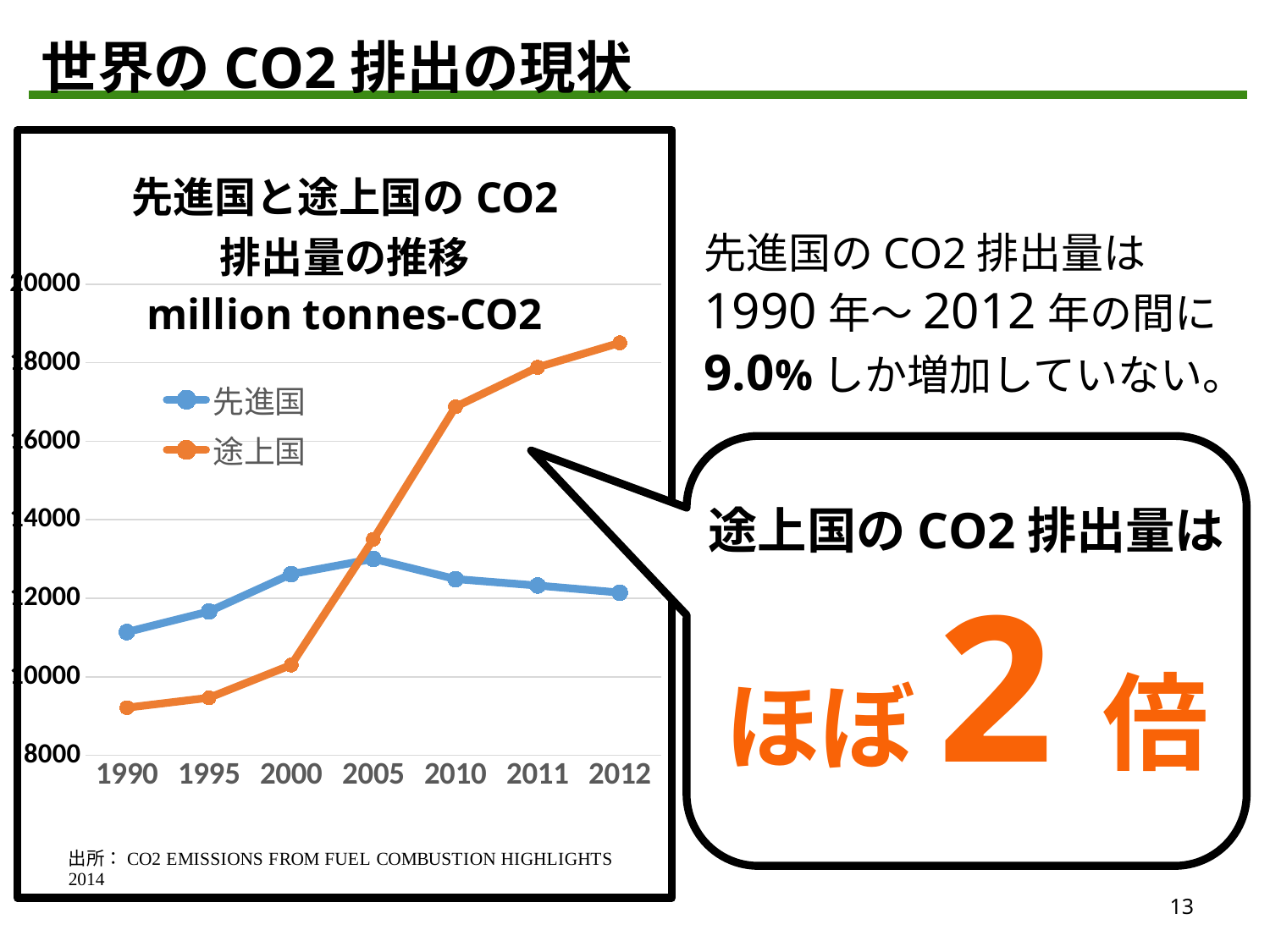
In which year is the value for 先進国 highest? 2005 Is the value for 先進国 in 1990 greater or less than 12000? less In 2012, which series has the higher value, 先進国 or 途上国? 途上国 In which year is the value for 途上国 highest? 2012 What kind of chart is shown on the slide? line chart How many series does the chart's legend list? 2 Is the value for 途上国 in 2012 greater or less than 18000? greater In 1990, which series has the higher value, 先進国 or 途上国? 先進国 What unit is stated in the chart title? million tonnes-CO2 Does the value for 途上国 rise or fall from 1990 to 2012? rise In which year is the value for 途上国 lowest? 1990 How many years are shown along the x axis of the chart? 7